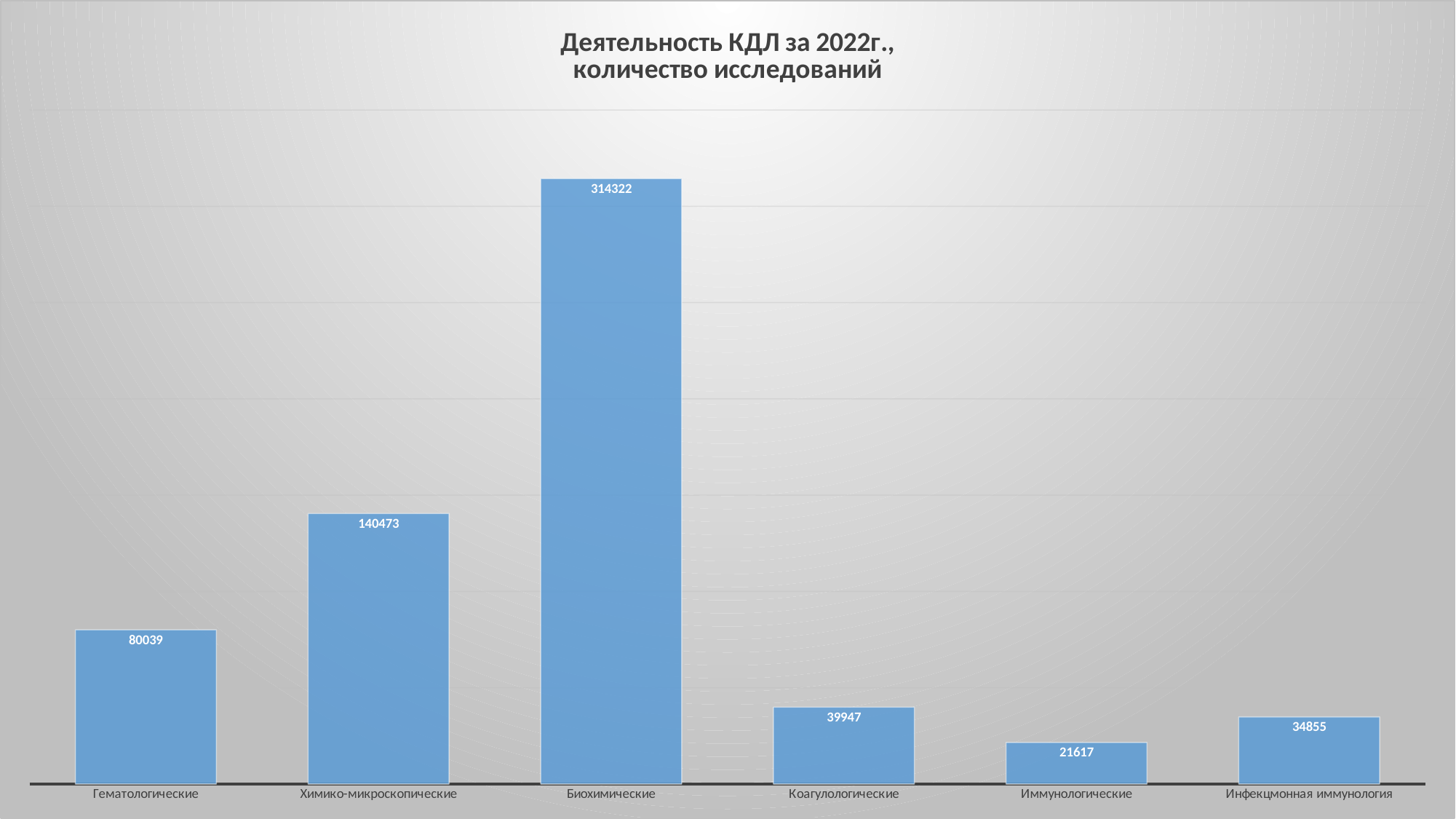
Which category has the lowest value? Иммунологические What is the value for Биохимические? 314322 Which is larger, the value for Химико-микроскопические or the value for Гематологические? Химико-микроскопические What kind of chart is this? bar chart What is the value for Инфекцмонная иммунология? 34855 What is the title of the chart? Деятельность КДЛ за 2022г., количество исследований What is the difference between the values for Коагулологические and Инфекцмонная иммунология? 5092 What is the value for Иммунологические? 21617 How many categories are shown on the chart? 6 What is the value for Гематологические? 80039 What is the difference between the values for Биохимические and Химико-микроскопические? 173849 Which category has the highest value? Биохимические